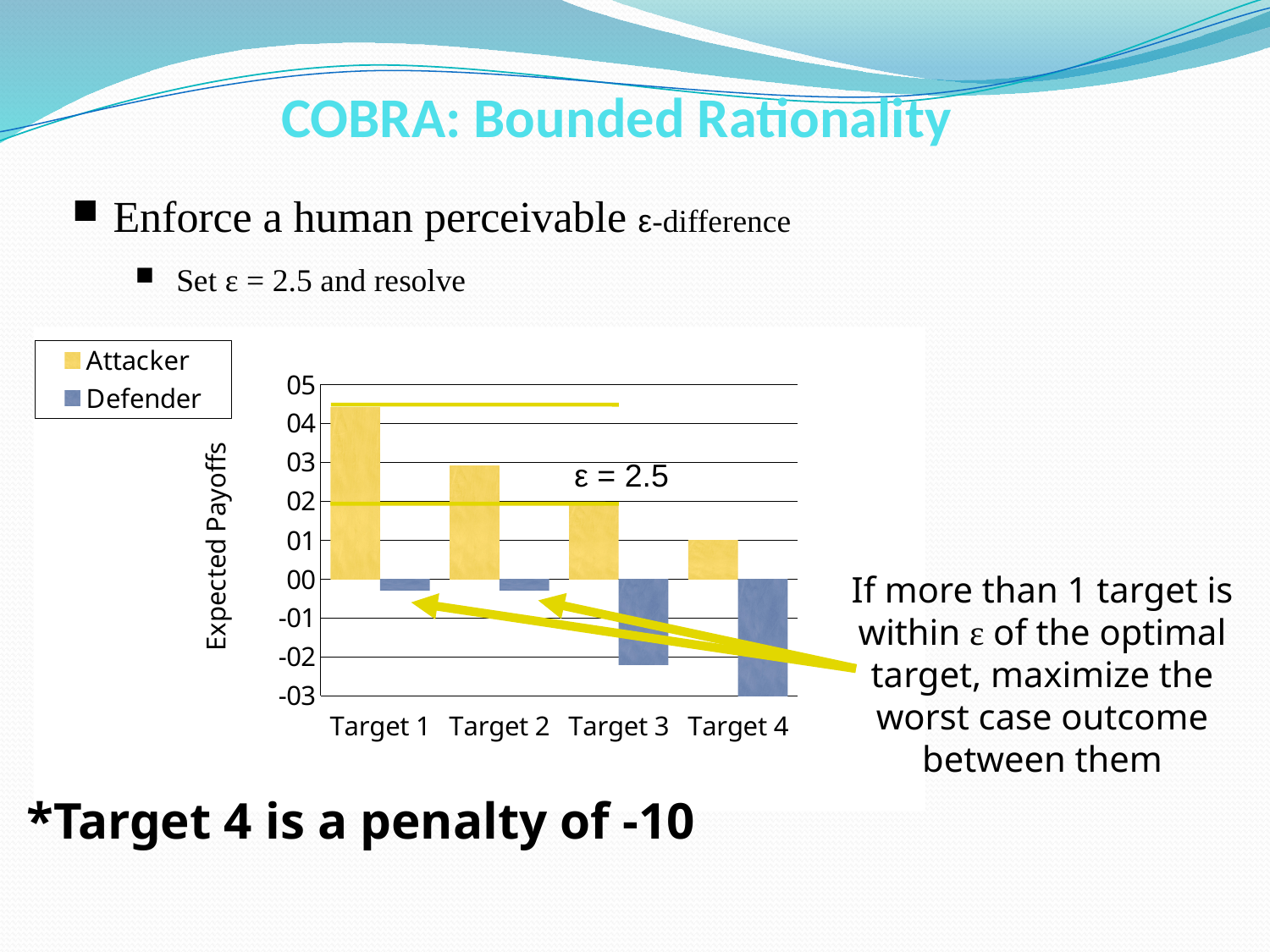
Which target has the lowest Attacker expected payoff? Target 4 What is the title of the chart's vertical axis? Expected Payoffs Which target has the highest Attacker expected payoff? Target 1 Is the Attacker expected payoff for Target 2 greater or less than 02? greater What kind of chart is shown on the slide? bar chart Which target has the lowest Defender expected payoff? Target 4 Is the Attacker expected payoff for Target 1 greater or less than 04? greater Which is larger, the Attacker expected payoff for Target 1 or for Target 2? Target 1 Is the Defender expected payoff for Target 3 greater or less than -01? less How many targets are shown along the x axis of the chart? 4 Do the Attacker expected payoffs rise or fall from Target 1 to Target 4? fall How many series does the chart legend list? 2